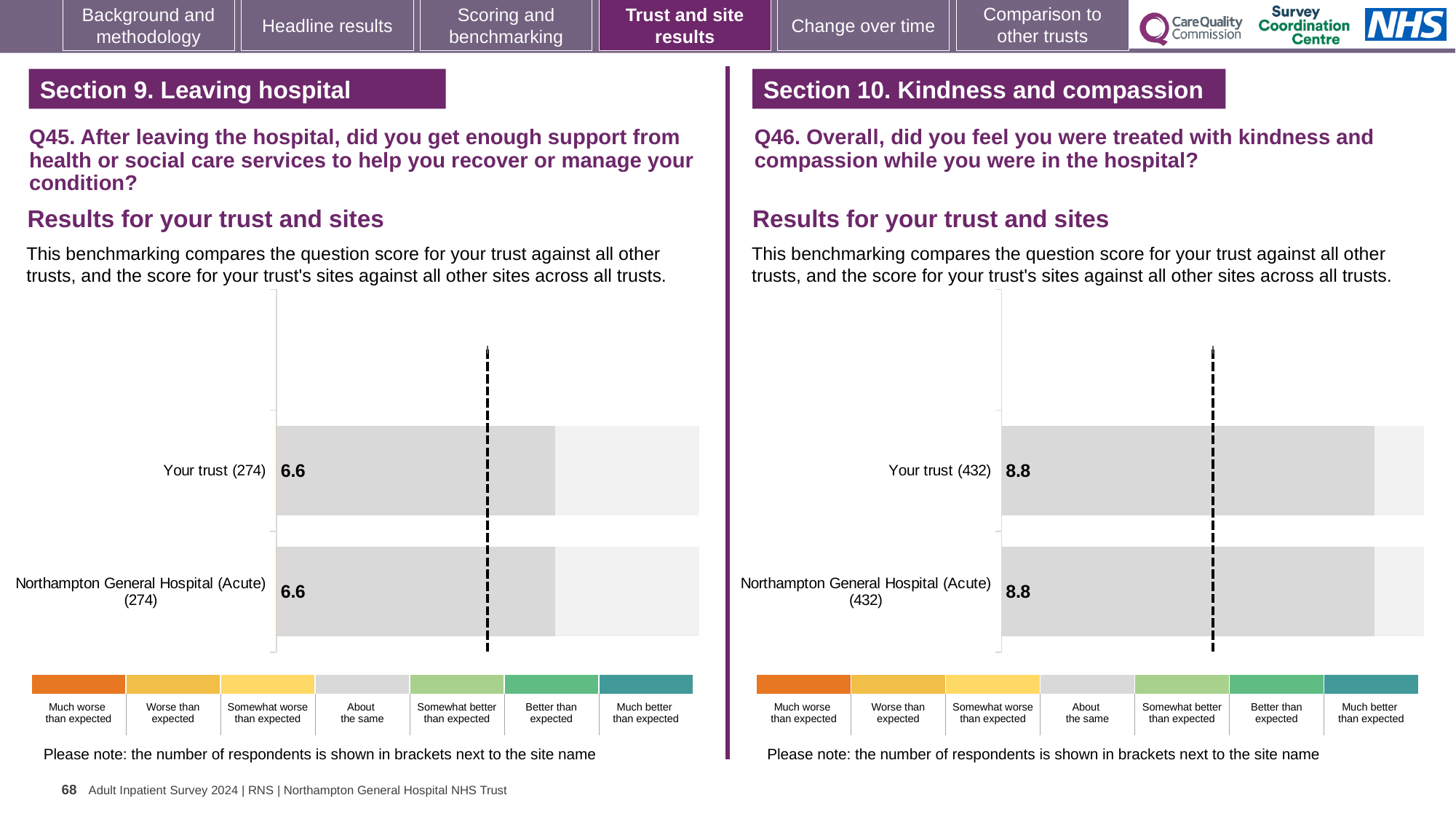
What kind of chart is used for the Q46 results (right)? Bar chart On the Q45 chart (left), what is the score for Your trust? 6.6 How many bars are plotted on the Q46 chart (right)? 2 On the Q45 chart (left), what is the difference between the score for Your trust and the score for Northampton General Hospital (Acute)? 0.0 On the Q46 chart (right), how many respondents are shown in brackets for Northampton General Hospital (Acute)? 432 On the Q45 chart (left), what is the score for Northampton General Hospital (Acute)? 6.6 How many bars are plotted on the Q45 chart (left)? 2 On the Q46 chart (right), what is the difference between the score for Your trust and the score for Northampton General Hospital (Acute)? 0.0 On the Q46 chart (right), what is the score for Your trust? 8.8 On the Q46 chart (right), what is the score for Northampton General Hospital (Acute)? 8.8 On the Q45 chart (left), how many respondents are shown in brackets for Your trust? 274 Is the score for Your trust on the Q46 chart (right) larger or smaller than the score for Your trust on the Q45 chart (left)? Larger